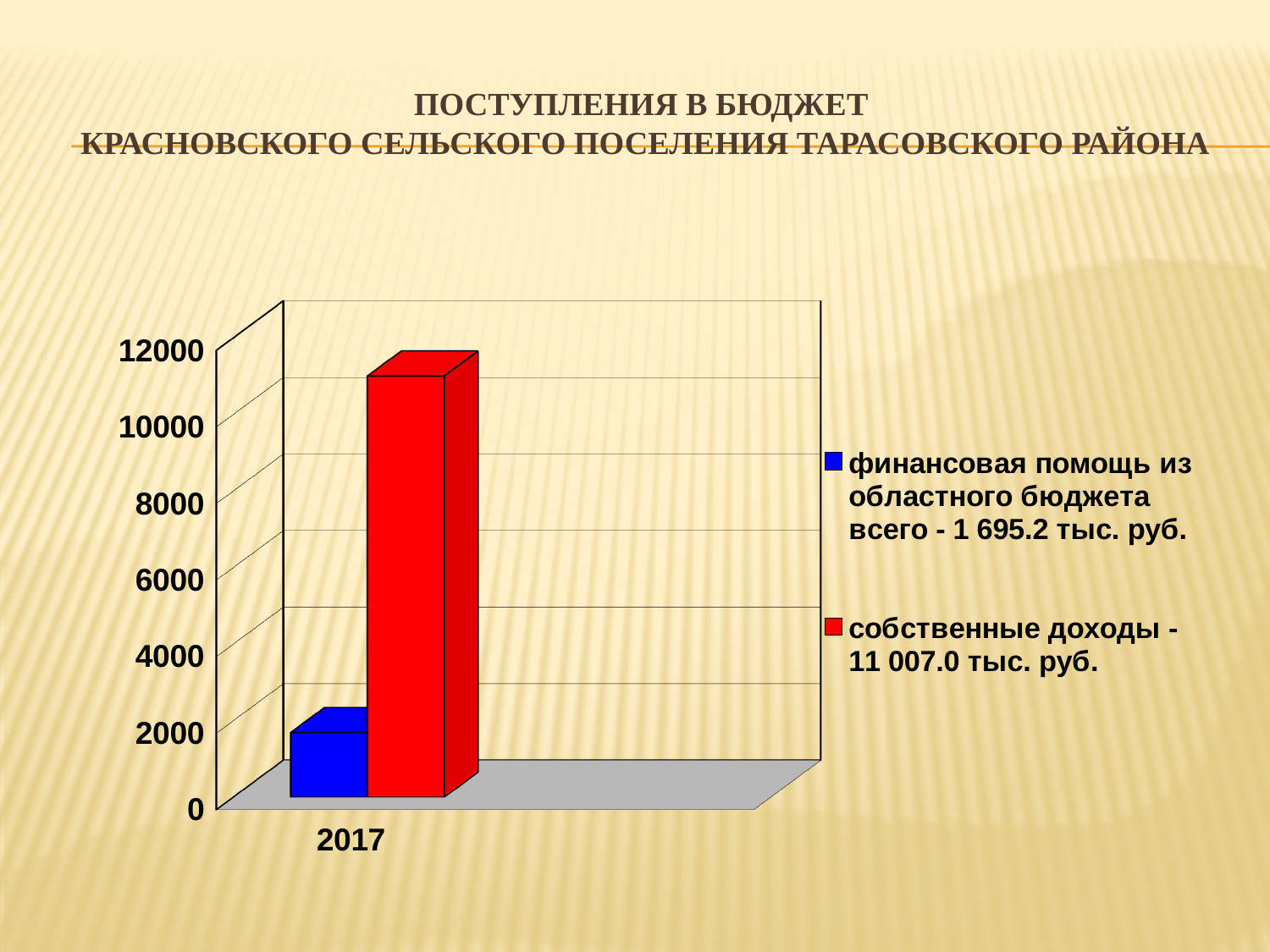
Which series has the higher value in 2017? собственные доходы What is the value of собственные доходы according to the legend? 11 007.0 тыс. руб. Is the value for финансовая помощь из областного бюджета greater or less than 2000? less What kind of chart is shown on the slide? bar chart How many series does the legend list? 2 What colour is the bar for собственные доходы? red What is the value of финансовая помощь из областного бюджета according to the legend? 1 695.2 тыс. руб. What is the difference between собственные доходы and финансовая помощь из областного бюджета? 9 311.8 тыс. руб. Which series has the lower value in 2017? финансовая помощь из областного бюджета Which year is shown on the x axis? 2017 How many categories are shown on the x axis? 1 Is the value for собственные доходы greater or less than 10000? greater